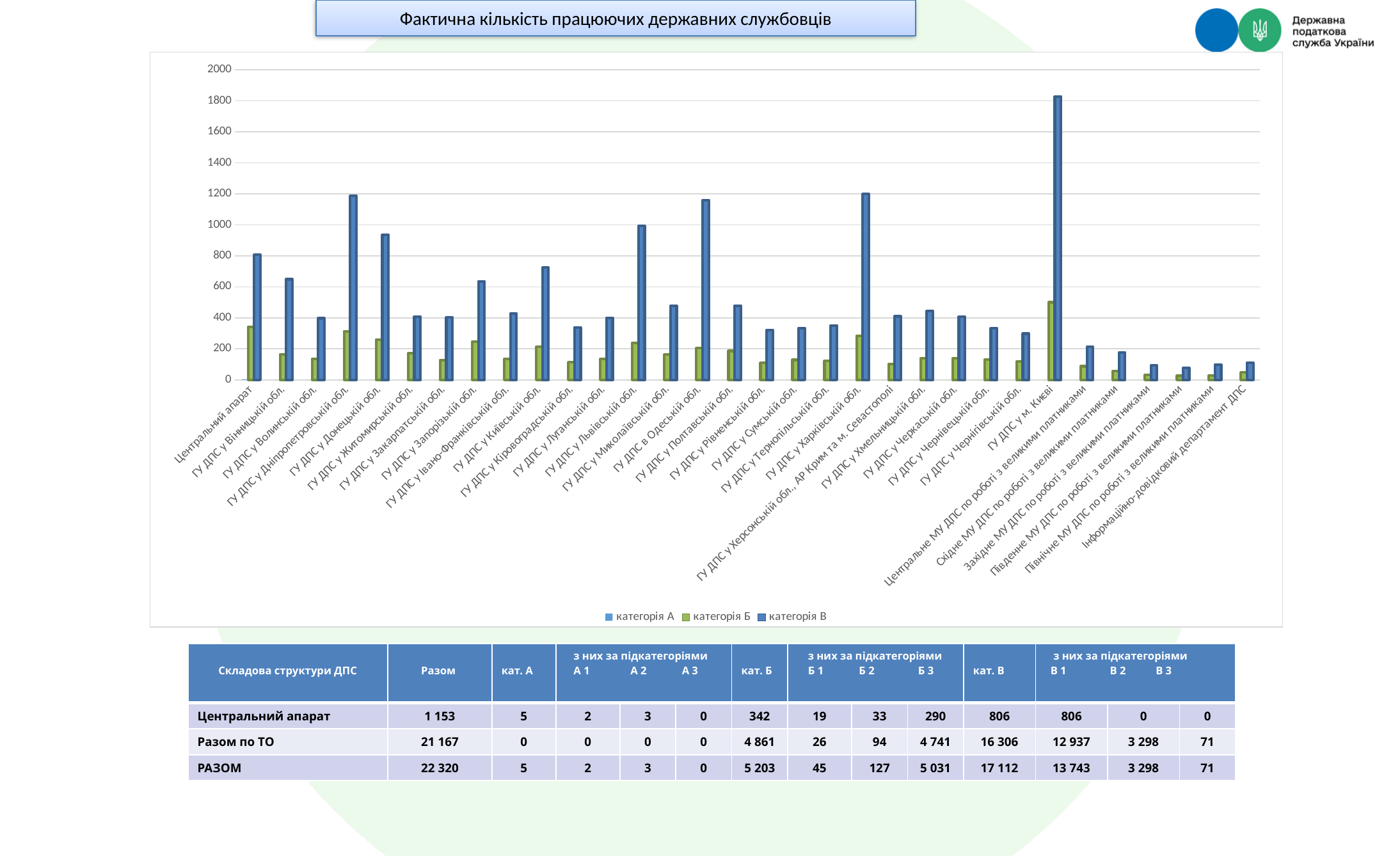
Is the категорія В value for ГУ ДПС у Харківській обл. greater or less than 1000? greater Is the категорія В value for ГУ ДПС у Дніпропетровській обл. greater or less than 1000? greater What is the title of the chart? Фактична кількість працюючих державних службовців Which is larger for категорія В: ГУ ДПС у Дніпропетровській обл. or ГУ ДПС у Вінницькій обл.? ГУ ДПС у Дніпропетровській обл. What kind of chart is shown on the slide? bar chart Is the категорія Б value for Центральний апарат greater or less than 200? greater Which is larger for категорія Б: ГУ ДПС у м. Києві or Центральний апарат? ГУ ДПС у м. Києві Which category has the highest value for категорія В? ГУ ДПС у м. Києві How many series does the chart legend list? 3